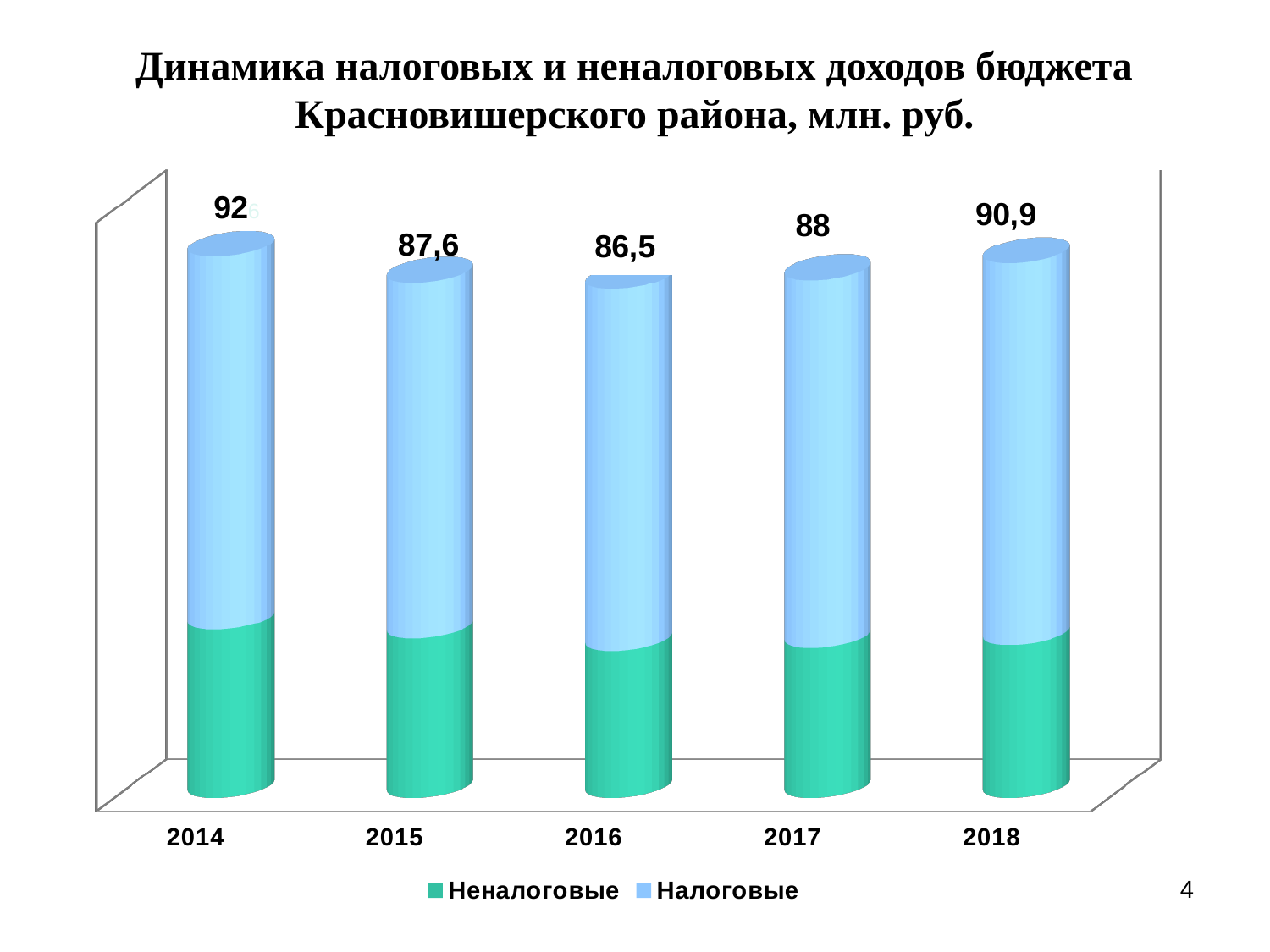
Which year has the highest total value? 2014 What is the total value shown for 2014? 92 How many years are shown on the x axis? 5 Which year has the larger total value, 2017 or 2015? 2017 What is the total value shown for 2016? 86,5 What kind of chart is shown on the slide? Stacked bar chart What is the total value shown for 2018? 90,9 What is the difference between the total values for 2014 and 2016? 5,5 What is the difference between the total values for 2018 and 2017? 2,9 How many series does the legend list? 2 Which year has the lowest total value? 2016 Do the total values rise or fall from 2014 to 2016? Fall